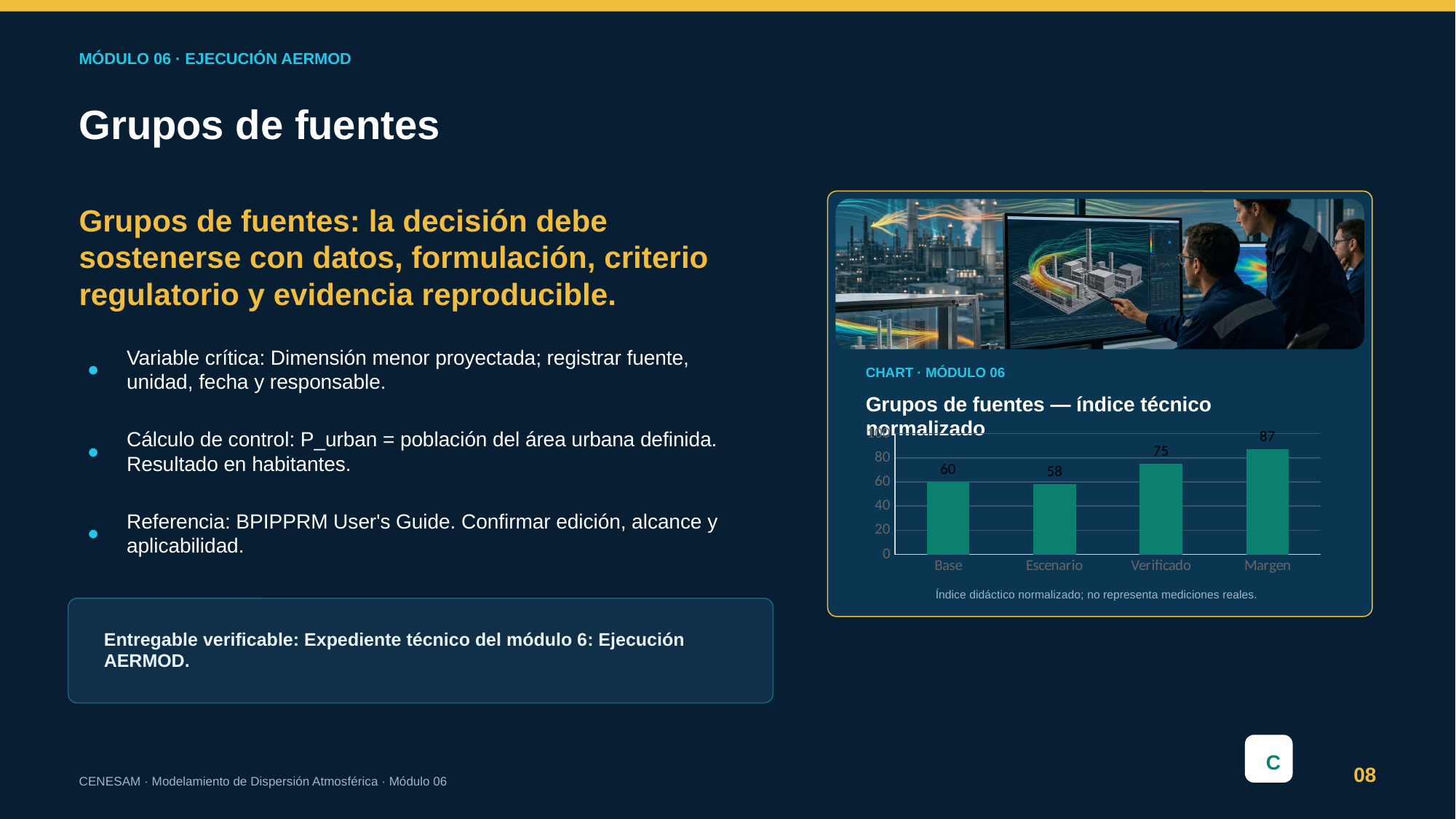
What is the difference between the values for Verificado and Escenario? 17 What kind of chart is shown? Bar chart What is the difference between the values for Margen and Base? 27 Which category has the lowest value? Escenario How many categories are shown on the x axis? 4 What is the value for Verificado? 75 What is the value for Margen? 87 What is the value for Base? 60 Which is larger, the value for Verificado or the value for Base? Verificado Which category has the highest value? Margen What is the title of the chart? Grupos de fuentes — índice técnico normalizado What is the value for Escenario? 58